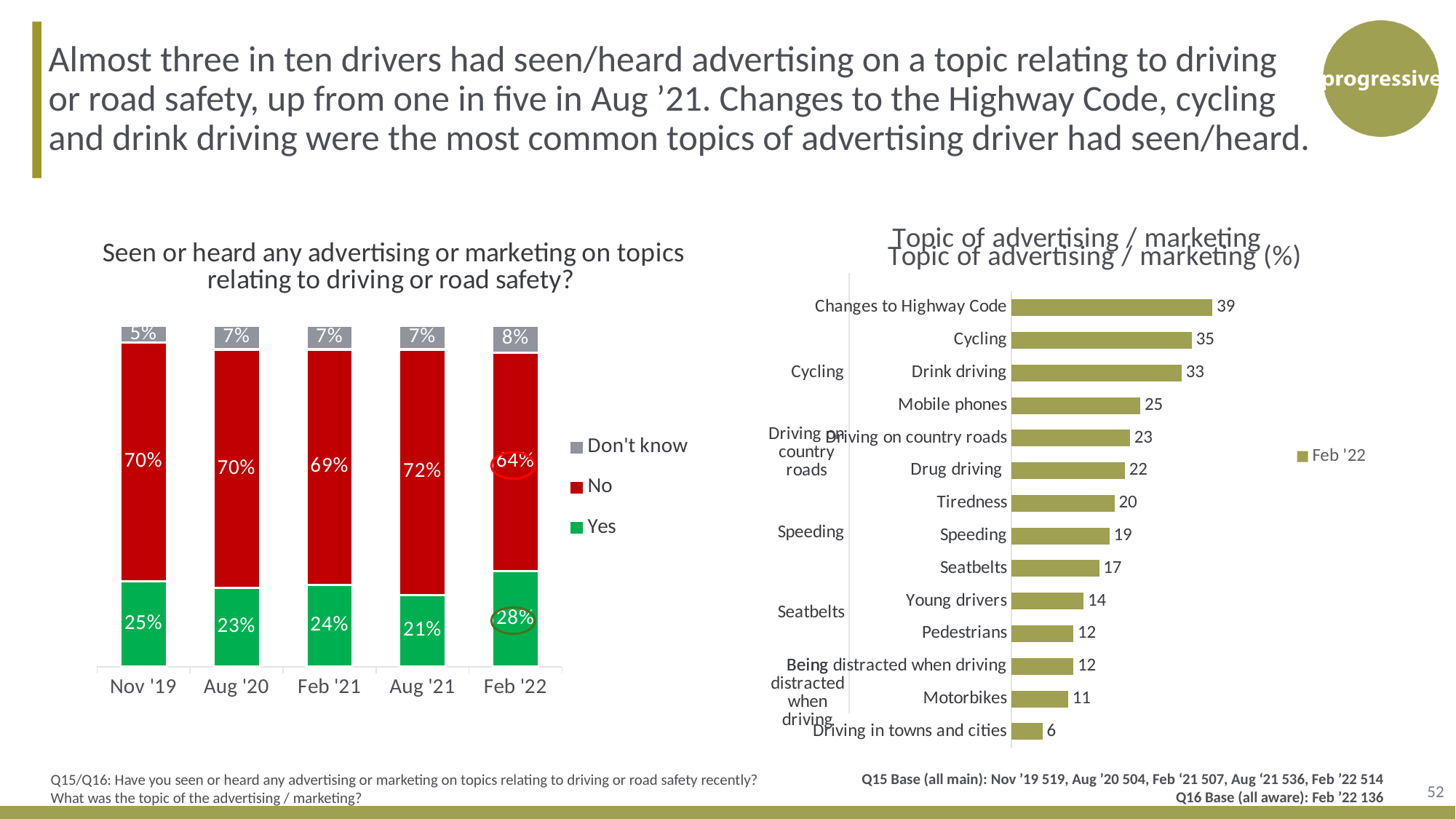
What kind of chart is the 'Topic of advertising / marketing (%)' chart? Bar chart In the 'Topic of advertising / marketing (%)' chart, what is the difference between Cycling and Mobile phones? 10 In the 'Topic of advertising / marketing (%)' chart, what is the value for Drink driving? 33 In the 'Seen or heard any advertising or marketing' chart, how many waves are shown on the x axis? 5 In the 'Seen or heard any advertising or marketing' chart, how many series does the legend list? 3 In the 'Topic of advertising / marketing (%)' chart, which topic has the lowest value? Driving in towns and cities In the 'Topic of advertising / marketing (%)' chart, which topic has the highest value? Changes to Highway Code In the 'Seen or heard any advertising or marketing' chart, what is the difference between the Yes percentage in Feb '22 and in Aug '21? 7% In the 'Topic of advertising / marketing (%)' chart, which is larger, Tiredness or Seatbelts? Tiredness In the 'Seen or heard any advertising or marketing' chart, which wave has the lowest Yes percentage? Aug '21 In the 'Seen or heard any advertising or marketing' chart, what percentage answered No in Aug '21? 72% In the 'Seen or heard any advertising or marketing' chart, what percentage answered Yes in Feb '22? 28%